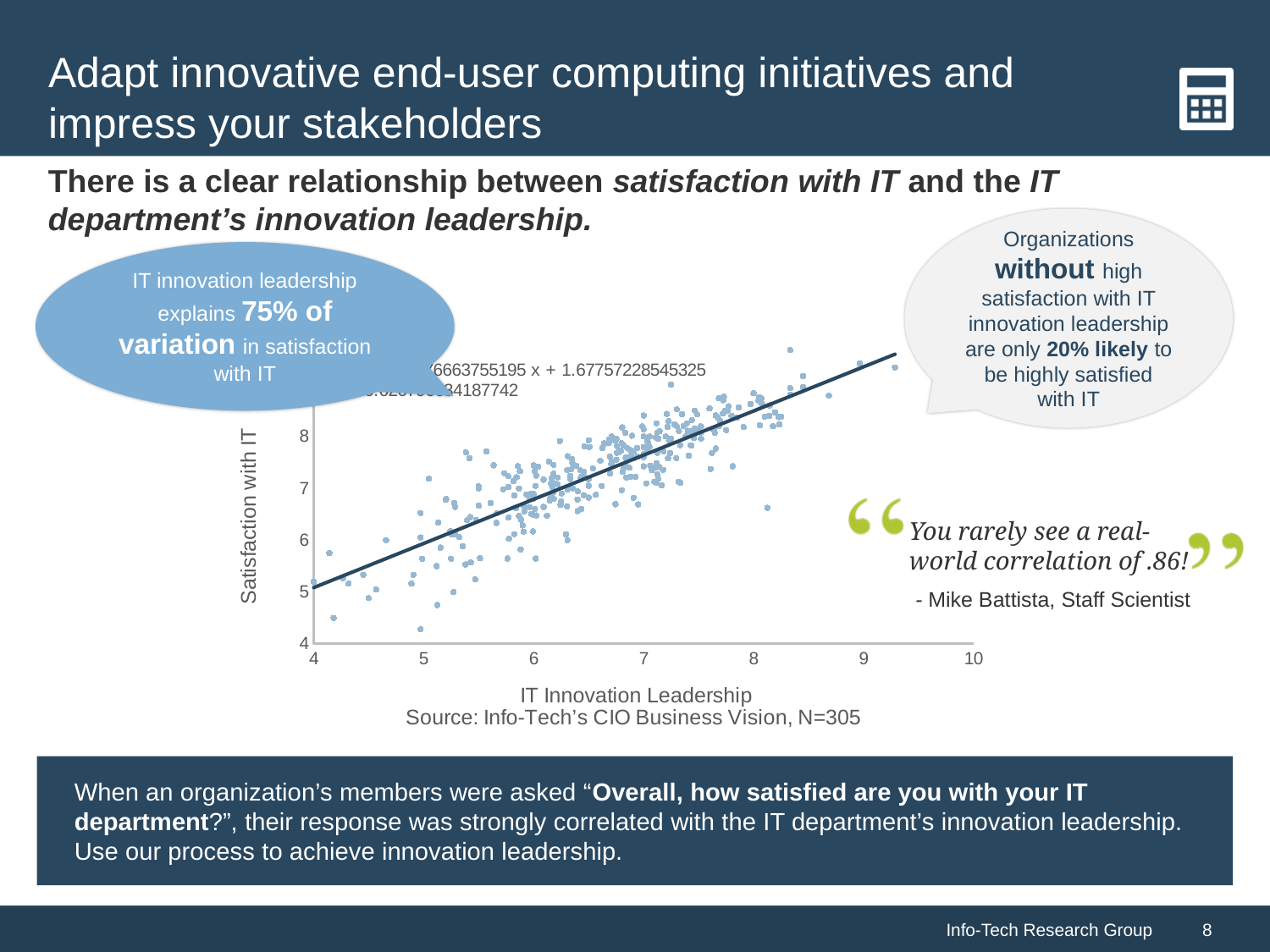
Does the trendline drawn through the scatter points slope upward or downward from left to right? Upward What is the label of the y axis of the chart? Satisfaction with IT What is the highest tick value shown on the x axis of the chart? 10 As IT Innovation Leadership increases along the x axis, does Satisfaction with IT generally rise or fall? Rise According to the source note under the chart, what is the sample size N? 305 What is the label of the x axis of the chart? IT Innovation Leadership What is the lowest tick value shown on the y axis of the chart? 4 What kind of chart is shown on the slide? Scatter chart